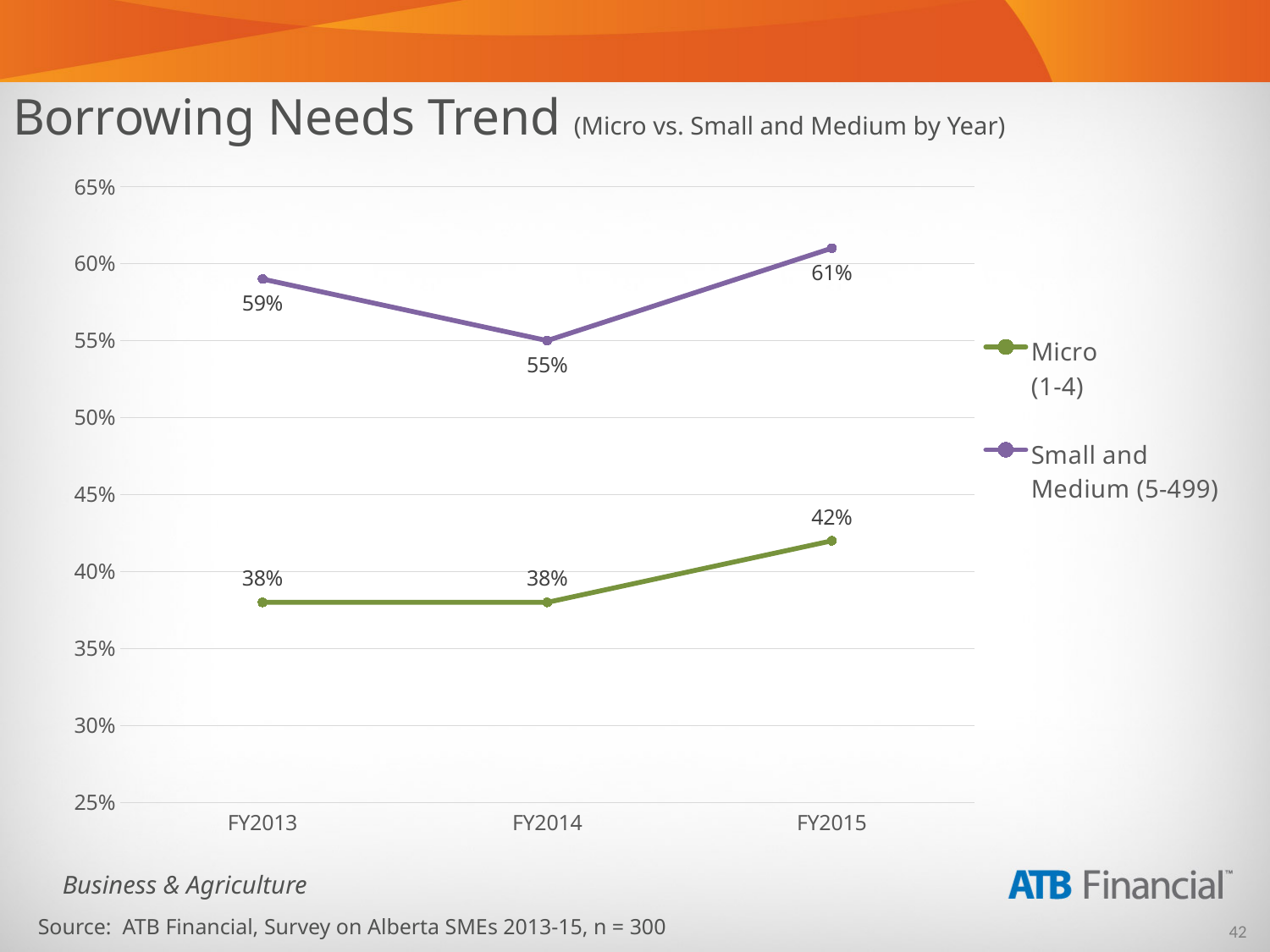
What is the value for Small and Medium (5-499) in FY2013? 59% What is the difference between the Small and Medium (5-499) and Micro (1-4) values in FY2015? 19% What is the value for Small and Medium (5-499) in FY2014? 55% In which year is the Small and Medium (5-499) value lowest? FY2014 Which series has the larger value in FY2014, Micro (1-4) or Small and Medium (5-499)? Small and Medium (5-499) In which year is the Small and Medium (5-499) value highest? FY2015 Does the Micro (1-4) value rise or fall from FY2014 to FY2015? Rise What is the value for Micro (1-4) in FY2015? 42% What kind of chart is shown on the slide? Line chart How many series does the legend list? 2 Is the value for Micro (1-4) in FY2013 greater or less than 40%? less How many years are shown on the x axis? 3